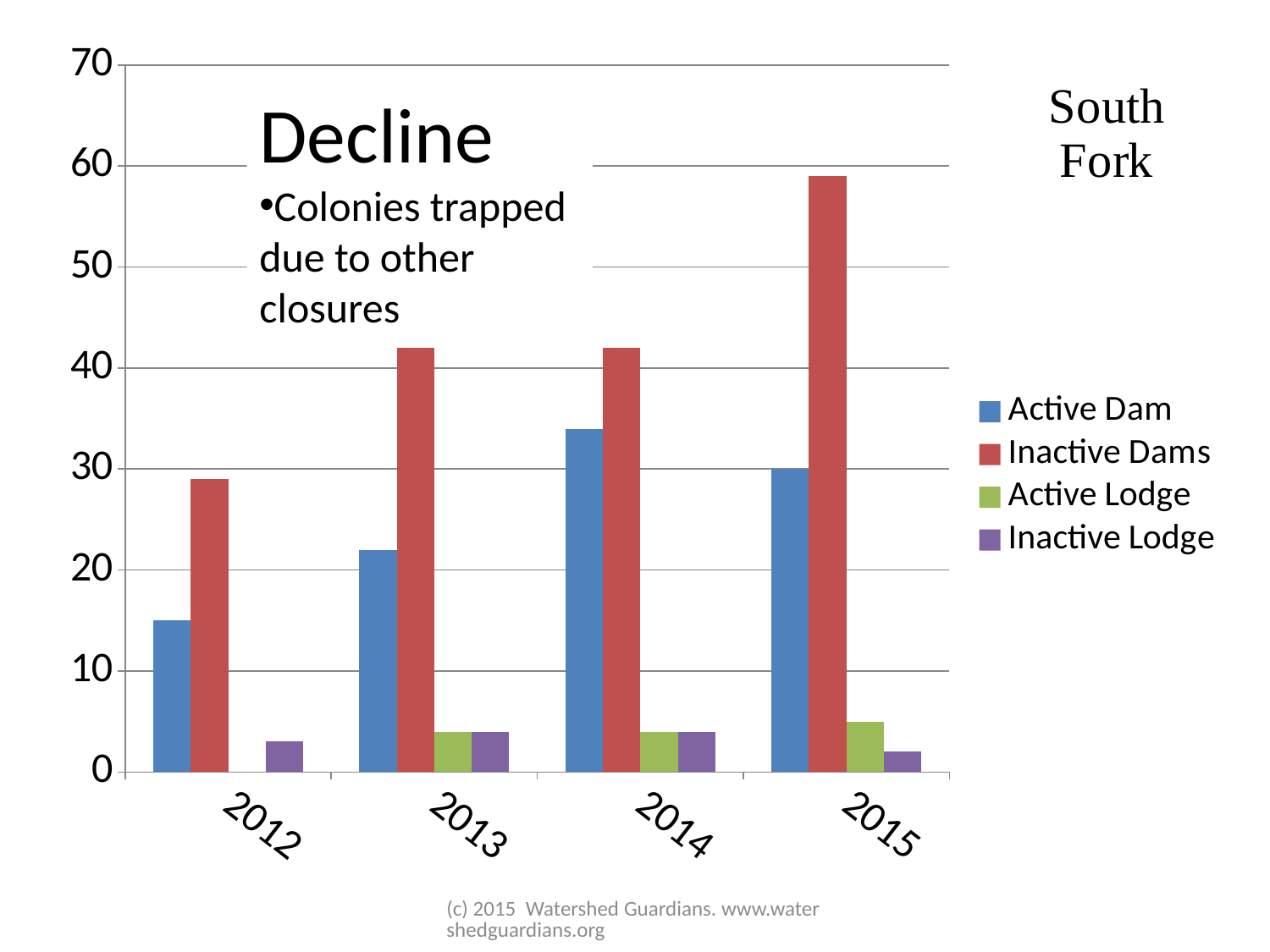
How many series does the legend list? 4 Is the Active Dam value for 2014 greater or less than 30? greater Is the Inactive Dams value for 2013 greater or less than 40? greater Does the Inactive Dams series rise or fall from 2012 to 2015? rise What kind of chart is shown on the slide? bar chart Which legend entry is shown in red? Inactive Dams In which year is the Inactive Dams value highest? 2015 Is the Inactive Dams value for 2015 greater or less than 50? greater In which year is the Active Dam value lowest? 2012 How many years are shown on the x axis? 4 Which is larger in 2014, Active Dam or Inactive Dams? Inactive Dams